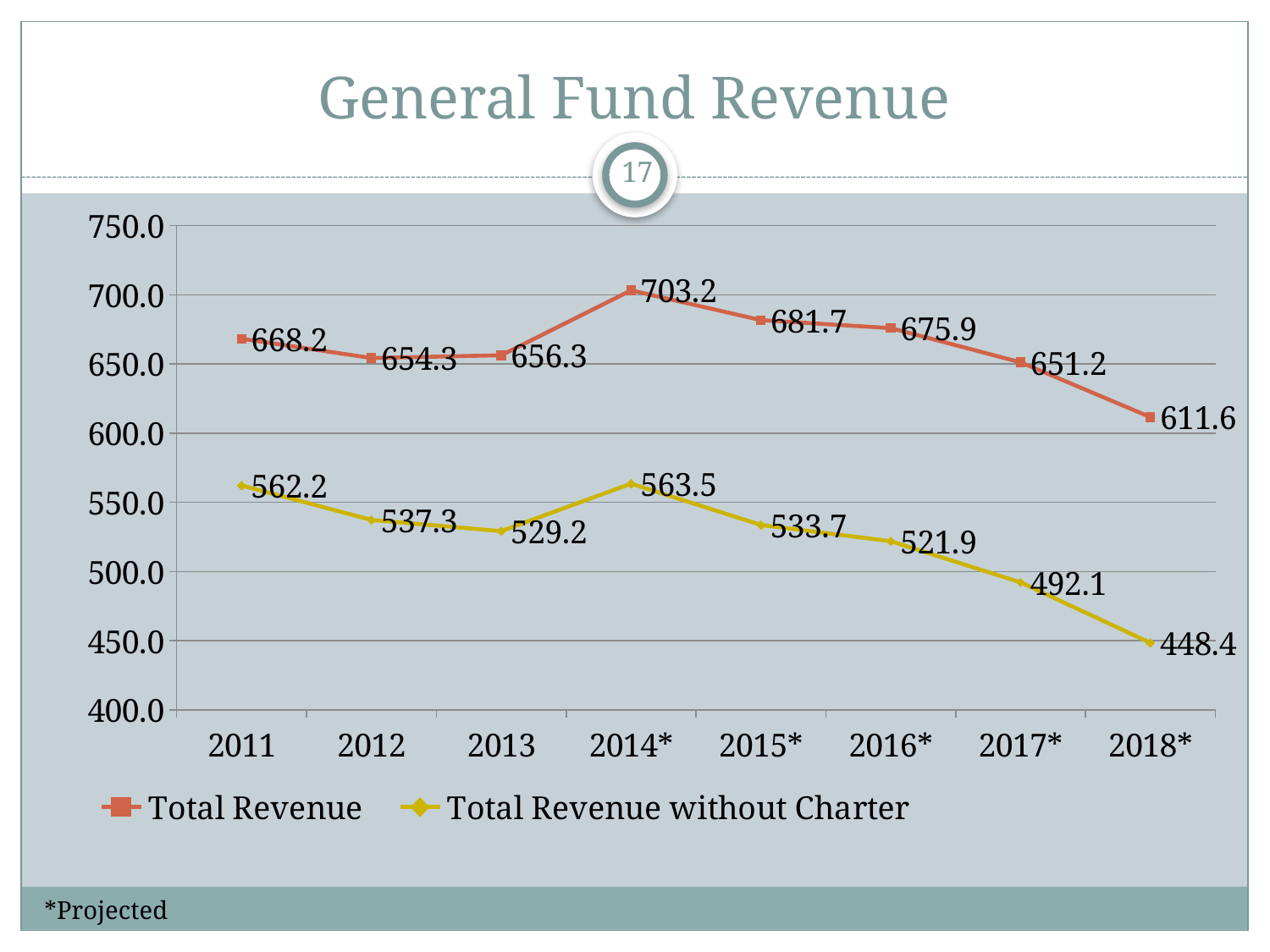
What kind of chart is shown on the slide? Line chart Which is larger: Total Revenue in 2012 or Total Revenue in 2013? Total Revenue in 2013 What is the difference between Total Revenue and Total Revenue without Charter in 2018*? 163.2 What is the Total Revenue without Charter value for 2018*? 448.4 In which year is Total Revenue highest? 2014* What is the title of the chart? General Fund Revenue What is the Total Revenue value for 2014*? 703.2 What is the Total Revenue value for 2011? 668.2 In which year is Total Revenue without Charter lowest? 2018* Does Total Revenue without Charter rise or fall from 2014* to 2018*? Fall How many series does the legend list? 2 How many years are shown on the x axis? 8